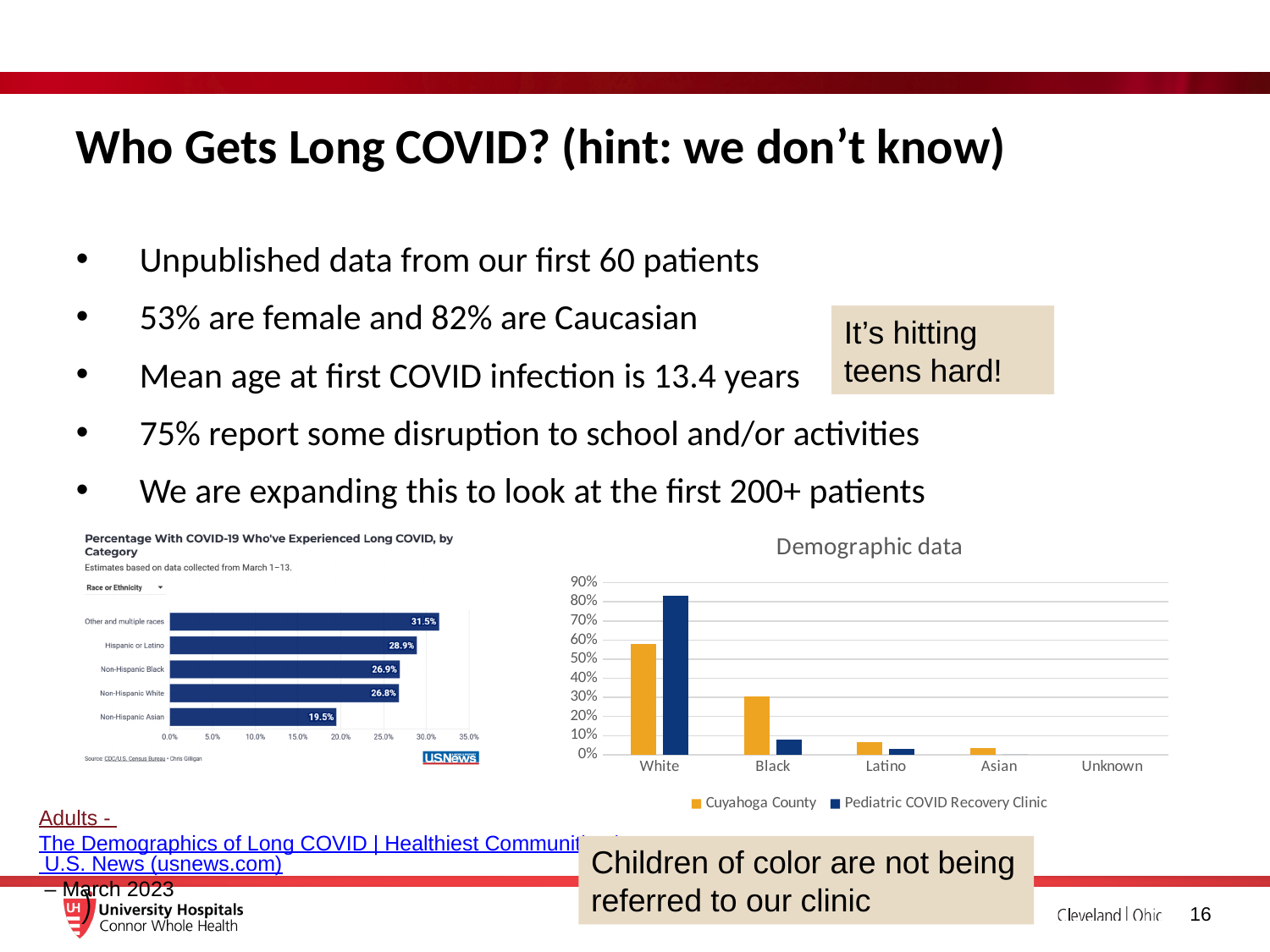
How many series does the legend list in the Demographic data chart? 2 What kind of chart is the Demographic data chart? bar chart In the Demographic data chart, is the Pediatric COVID Recovery Clinic value for Black greater or less than 10%? less In the left chart (Percentage With COVID-19 Who've Experienced Long COVID, by Category), what is the value for Hispanic or Latino? 28.9% In the left chart (Percentage With COVID-19 Who've Experienced Long COVID, by Category), what is the difference between Other and multiple races and Non-Hispanic Asian? 12.0% In the left chart (Percentage With COVID-19 Who've Experienced Long COVID, by Category), what is the value for Non-Hispanic Black? 26.9% In the Demographic data chart, for the Black category, which series has the larger value? Cuyahoga County In the left chart (Percentage With COVID-19 Who've Experienced Long COVID, by Category), which category has the highest value? Other and multiple races How many categories are shown on the x axis of the Demographic data chart? 5 In the Demographic data chart, is the Pediatric COVID Recovery Clinic value for White greater or less than 70%? greater How many categories are shown in the left chart (Percentage With COVID-19 Who've Experienced Long COVID, by Category)? 5 In the left chart (Percentage With COVID-19 Who've Experienced Long COVID, by Category), which category has the lowest value? Non-Hispanic Asian